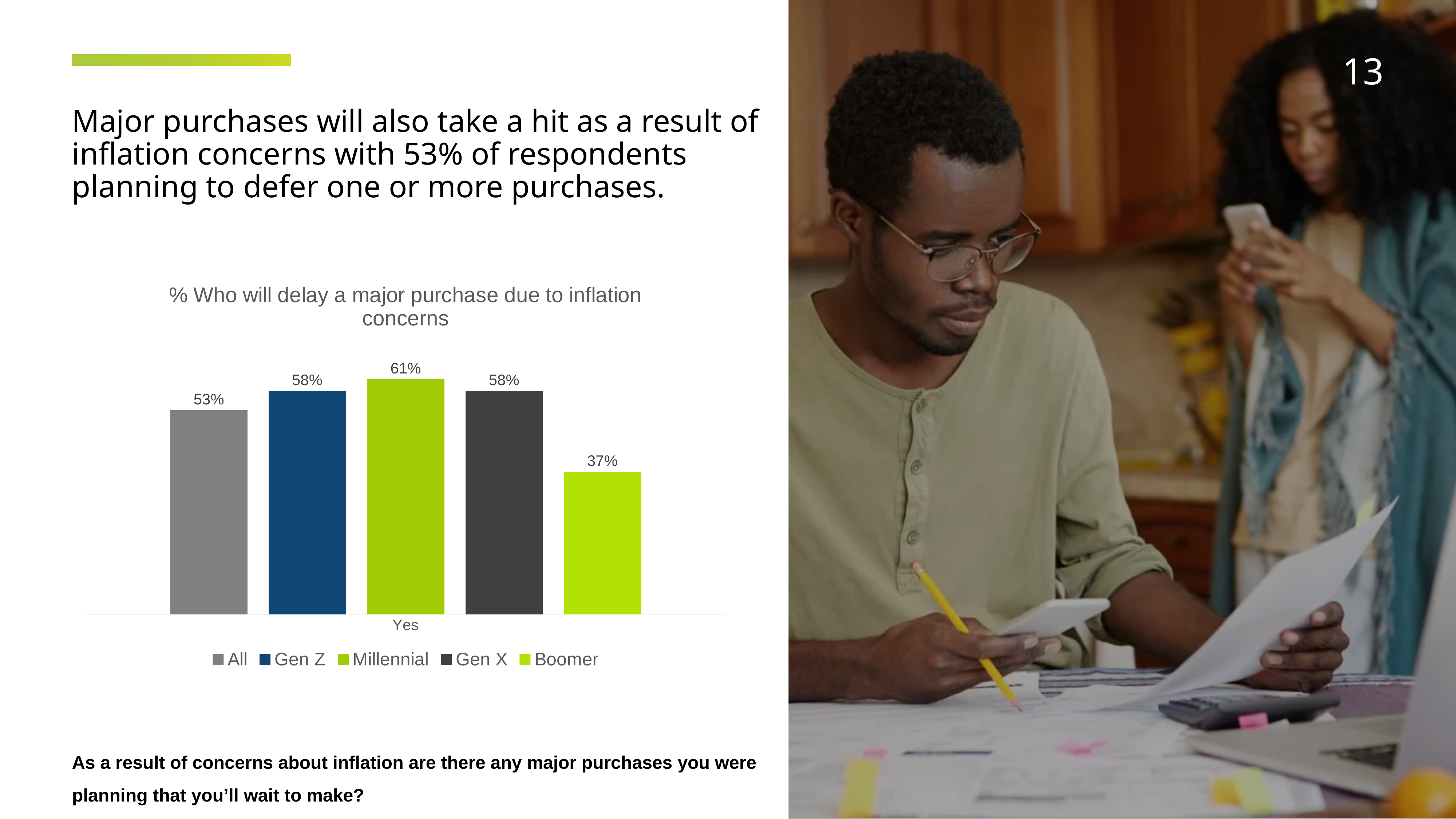
What is the difference between the Gen X and All values? 5% How many series does the legend list? 5 What is the value for Millennial in the chart? 61% What is the value for Gen Z in the chart? 58% What is the value for All in the chart? 53% What is the value for Boomer in the chart? 37% What kind of chart is shown on the slide? Bar chart Which series has the lowest value in the chart? Boomer Which is larger, the value for Gen Z or the value for Boomer? Gen Z What is the difference between the Millennial and Boomer values? 24% Which series has the highest value in the chart? Millennial What is the title of the chart? % Who will delay a major purchase due to inflation concerns